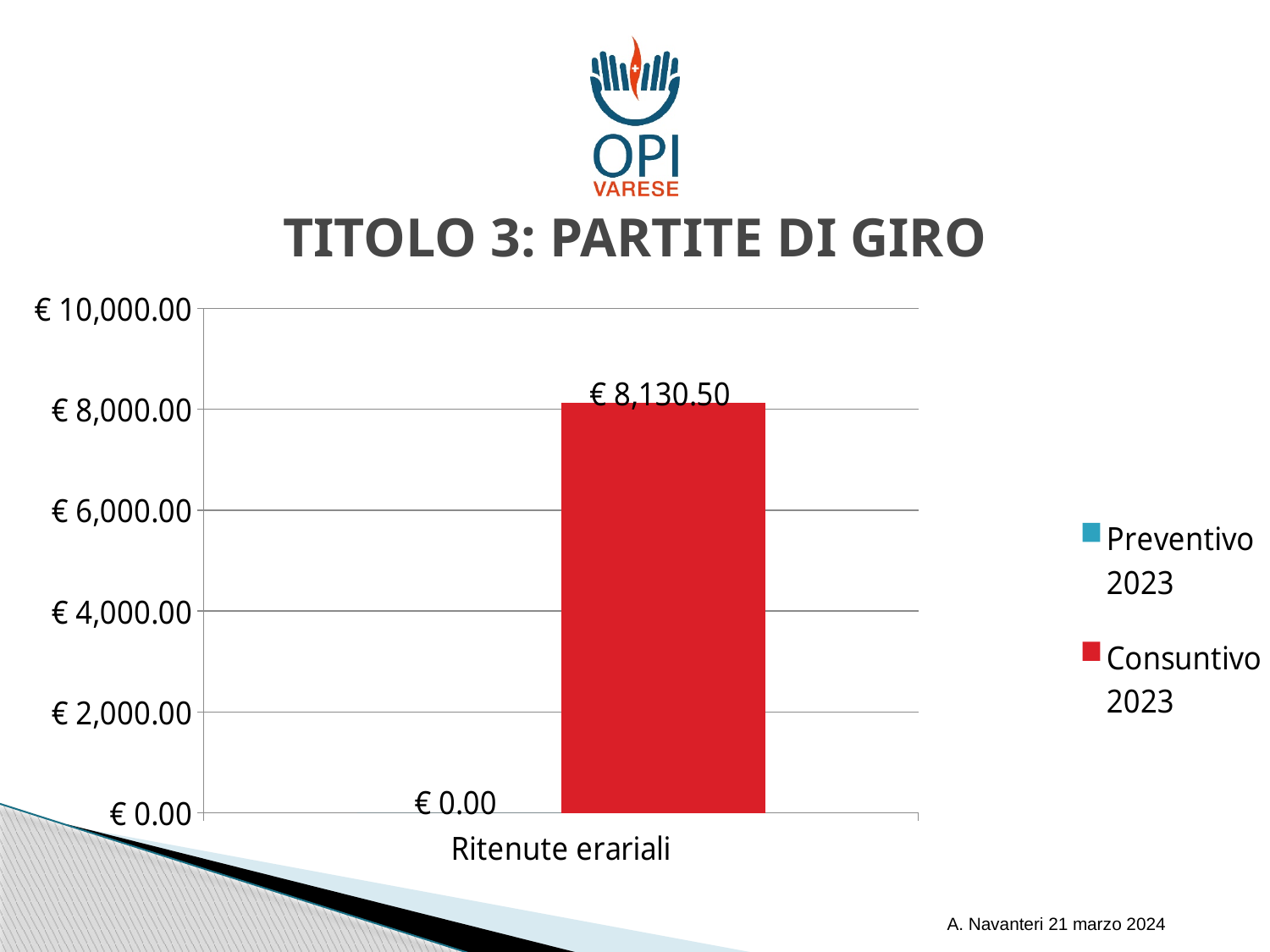
What kind of chart is shown on the slide? bar chart What is the difference between the Consuntivo 2023 and Preventivo 2023 values for Ritenute erariali? € 8,130.50 Is the Consuntivo 2023 value for Ritenute erariali greater or less than € 8,000.00? greater What is the category label shown on the x axis? Ritenute erariali Which series has the higher value for Ritenute erariali, Preventivo 2023 or Consuntivo 2023? Consuntivo 2023 What is the title of the chart? TITOLO 3: PARTITE DI GIRO How many series does the legend list? 2 Is the Consuntivo 2023 value for Ritenute erariali greater or less than € 10,000.00? less What is the Consuntivo 2023 value for Ritenute erariali? € 8,130.50 What is the Preventivo 2023 value for Ritenute erariali? € 0.00 How many categories are shown on the x axis of the chart? 1 What colour is the Consuntivo 2023 series in the legend? red